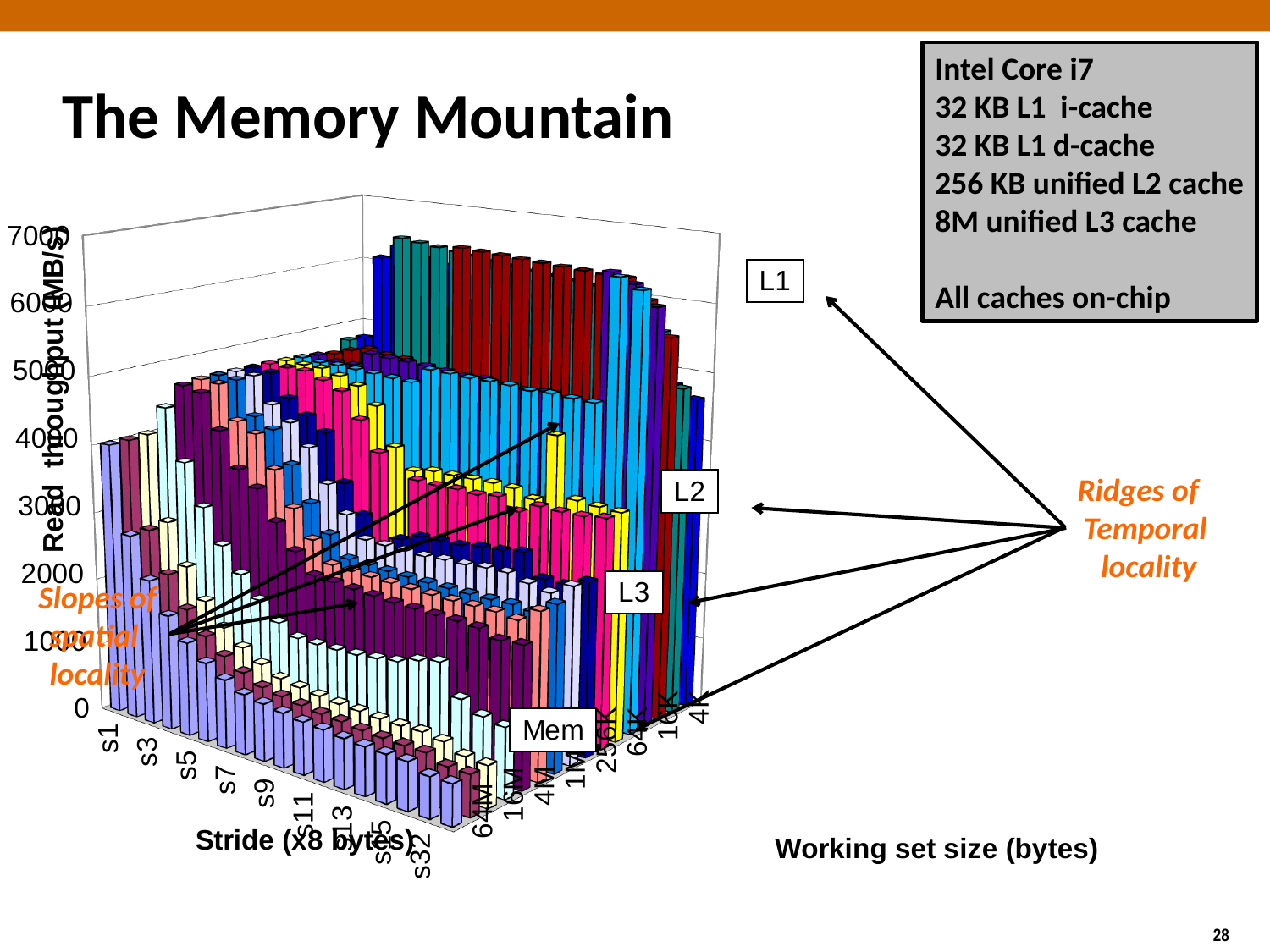
Is the read throughput of the tallest bars in the L1 ridge greater or less than 5000 MB/s? greater Which region of the chart has the lowest read throughput: L1, L2, L3, or Mem? Mem Which region of the chart has the highest read throughput: L1, L2, L3, or Mem? L1 What is the maximum value shown on the vertical axis of the chart? 7000 For a fixed large working set size, does read throughput rise or fall as the stride increases from s1 to s32? fall What kind of chart is shown on the slide? 3D bar chart For a fixed stride, does read throughput rise or fall as the working set size decreases from 64M toward 4K? rise What is the minimum value shown on the vertical axis of the chart? 0 Which has higher read throughput on the chart, the L2 ridge or the L3 ridge? L2 What is the label of the vertical axis of the chart? Read throughput (MB/s) What is the title of the slide containing the chart? The Memory Mountain